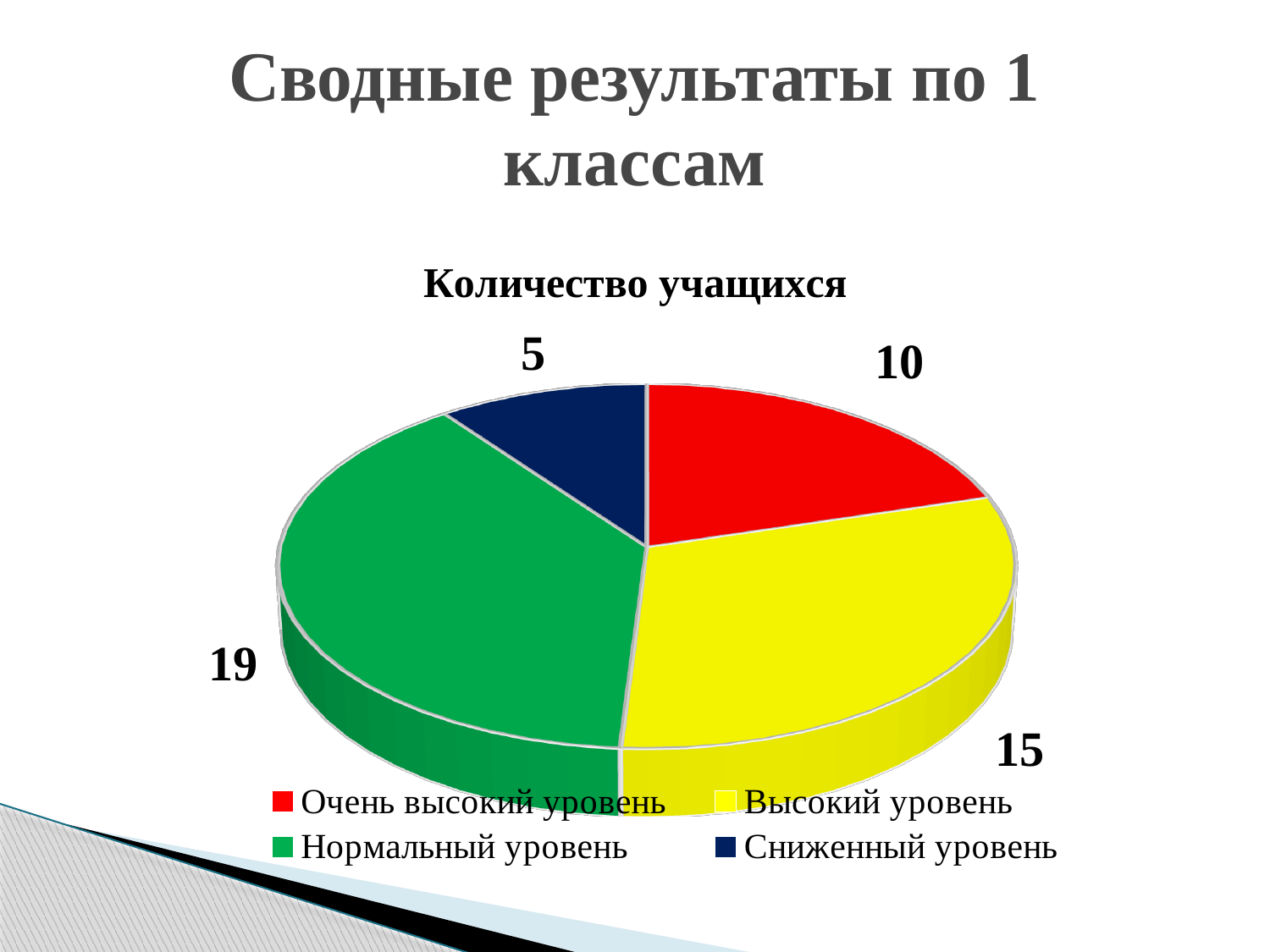
What is the value for Сниженный уровень? 5 How many entries does the legend list? 4 What is the difference between the values for Нормальный уровень and Сниженный уровень? 14 What is the title of the chart? Количество учащихся What kind of chart is shown on the slide? Pie chart What is the value for Высокий уровень? 15 What is the value for Нормальный уровень? 19 What is the total of all slices in the pie chart? 49 Which category has the largest slice? Нормальный уровень What is the value for Очень высокий уровень? 10 Which category has the smallest slice? Сниженный уровень How many slices does the pie chart have? 4